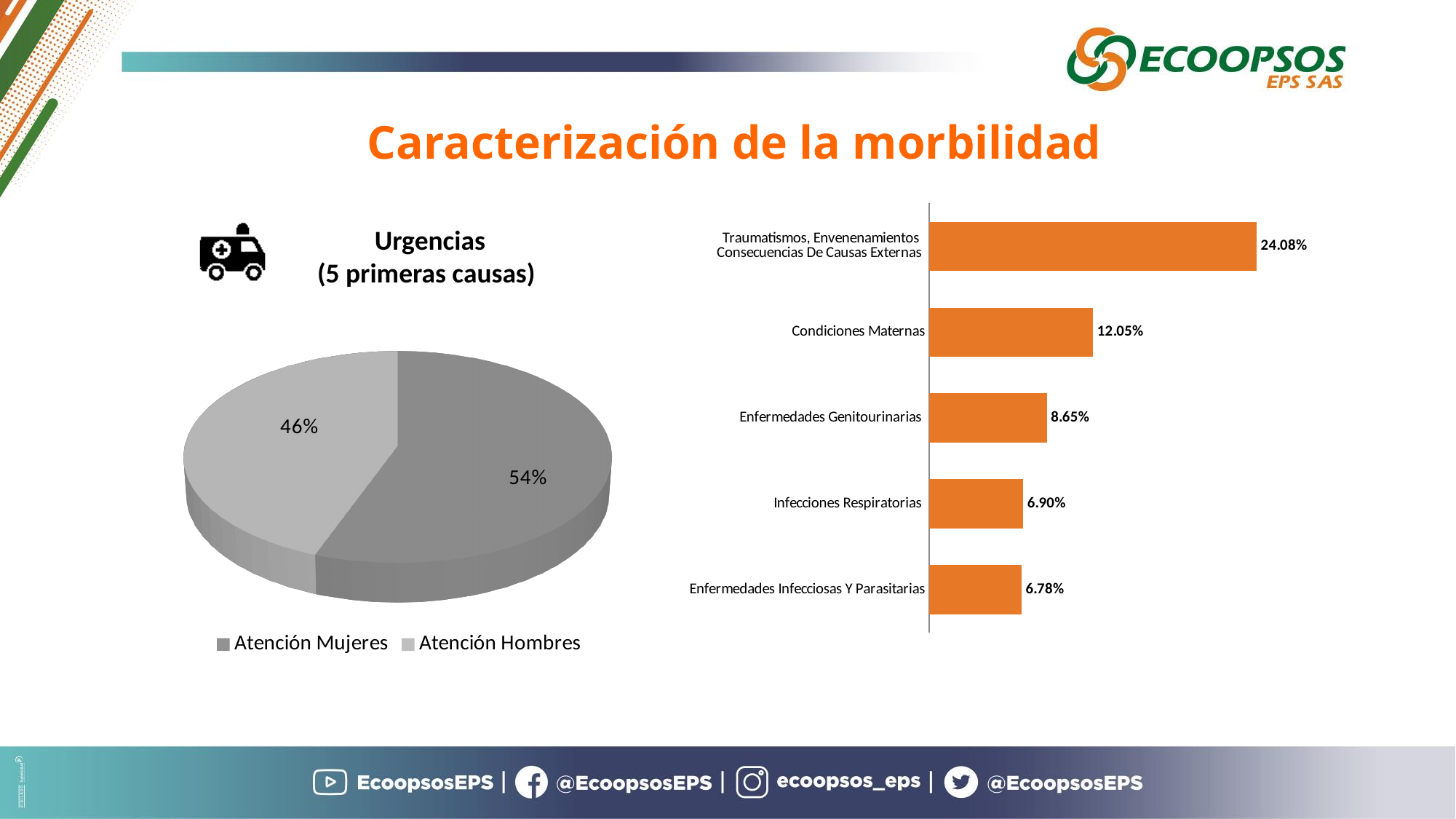
In the bar chart on the right, what is the difference between the values for Traumatismos, Envenenamientos Consecuencias De Causas Externas and Condiciones Maternas? 12.03% In the bar chart on the right, what is the value for Enfermedades Genitourinarias? 8.65% In the bar chart on the right, which category has the highest value? Traumatismos, Envenenamientos Consecuencias De Causas Externas What kind of chart is the chart on the left of the slide? Pie chart What kind of chart is the chart on the right of the slide? Bar chart In the pie chart on the left, what share is labelled for Atención Mujeres? 54% In the bar chart on the right, what is the value for Condiciones Maternas? 12.05% How many categories are shown in the bar chart on the right? 5 How many entries does the legend of the pie chart on the left list? 2 In the bar chart on the right, which category has the lowest value? Enfermedades Infecciosas Y Parasitarias In the pie chart on the left, what share is labelled for Atención Hombres? 46% In the pie chart on the left, which slice is larger, Atención Mujeres or Atención Hombres? Atención Mujeres